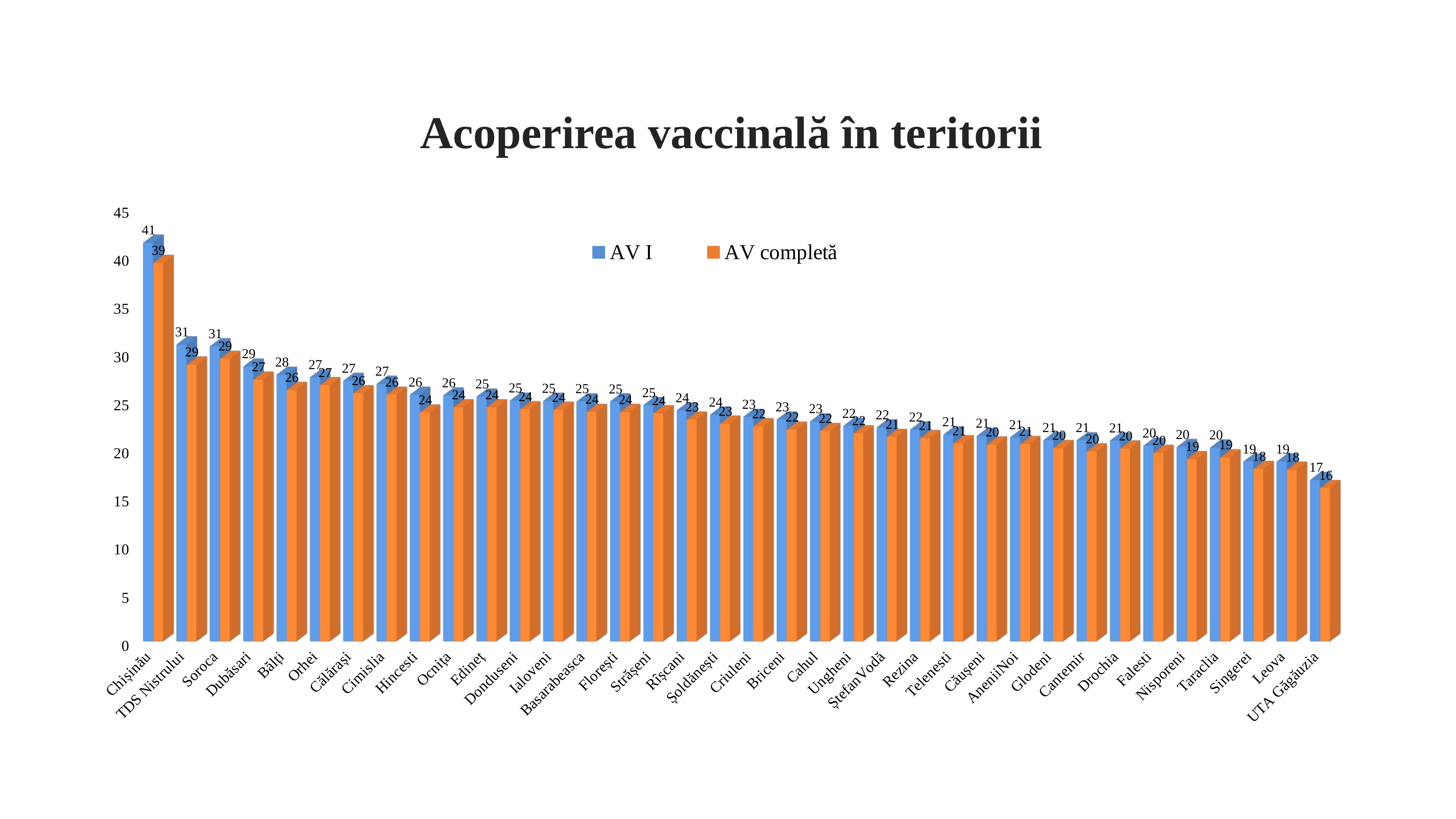
What kind of chart is shown on the slide? Bar chart How many territories are shown on the x axis? 36 Do the AV I values rise or fall from left to right along the x axis? Fall How many series does the legend list? 2 What is the AV completă value for Dubăsari? 27 Which territory has the highest AV completă value? Chișinău What is the AV I value for Chișinău? 41 Which territory has the lowest AV I value? UTA Găgăuzia Which is larger, the AV I value for Bălți or the AV I value for Leova? Bălți What is the difference between the AV I and AV completă values for Chișinău? 2 What is the AV I value for UTA Găgăuzia? 17 What is the difference between the AV I values for Chișinău and Soroca? 10